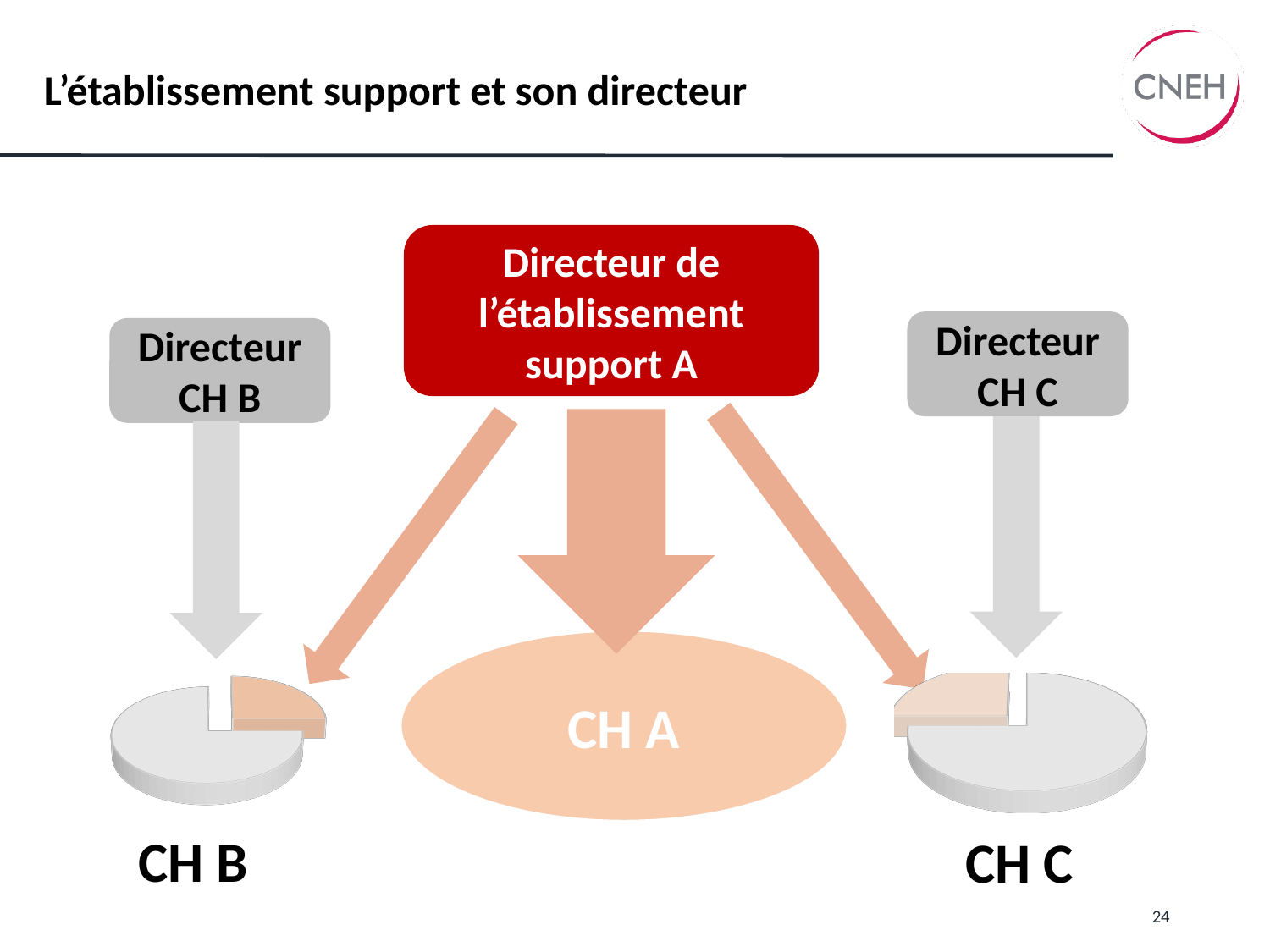
In the CH C pie chart, is the orange slice greater or less than 50% of the pie? less In the CH B pie chart, which slice is larger, the grey slice or the orange slice? the grey slice In the CH B pie chart, is the orange slice greater or less than 50% of the pie? less How many slices does the CH C pie chart have? 2 How many pie charts are shown on the slide? 2 What label is written below the left pie chart? CH B In the CH C pie chart, which slice is larger, the grey slice or the orange slice? the grey slice What kind of chart is shown below the label CH C? pie chart How many slices does the CH B pie chart have? 2 What kind of chart is shown below the label CH B? pie chart What label is written below the right pie chart? CH C